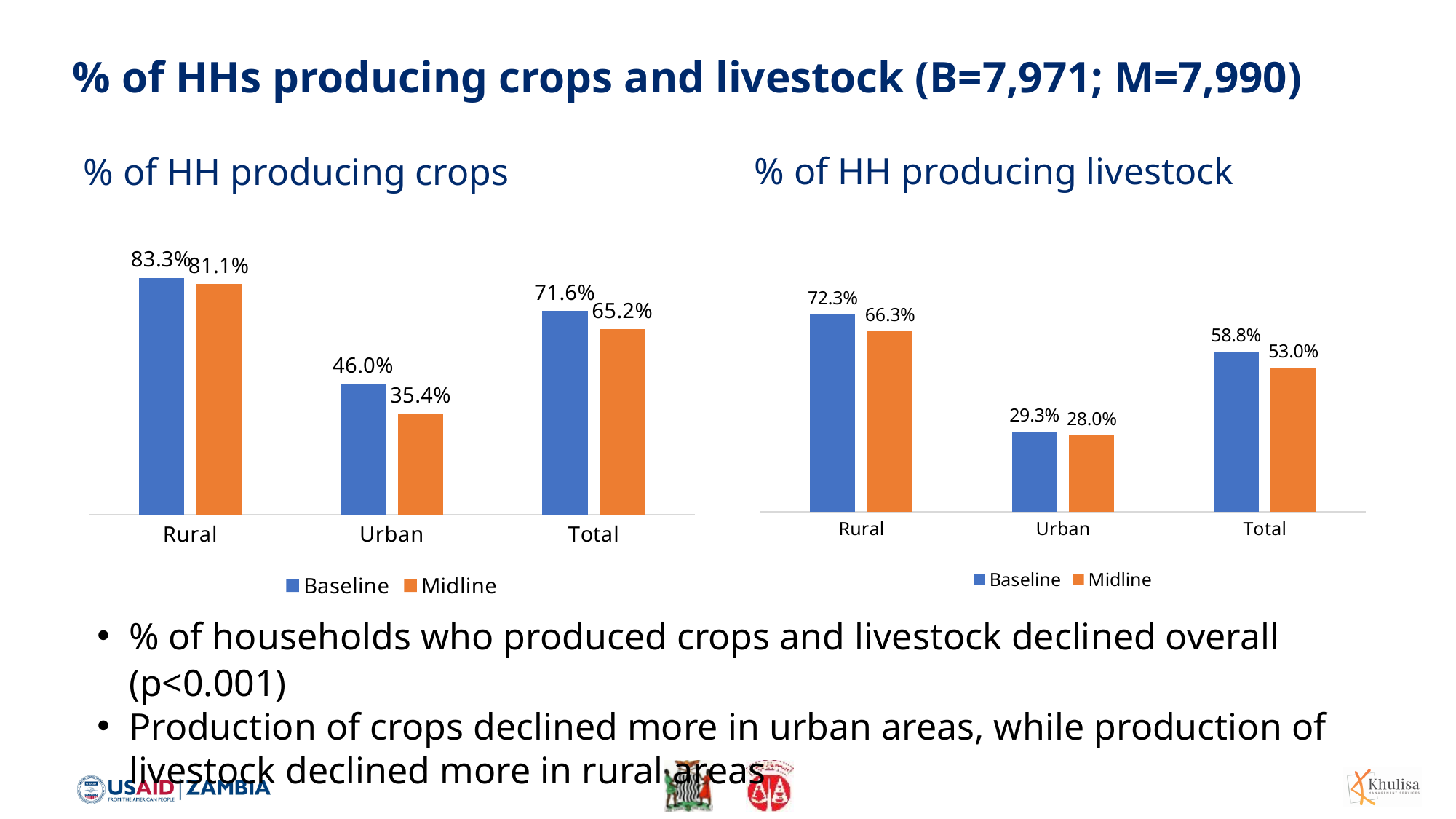
In the '% of HH producing crops' chart, which is larger: the Baseline value for Total or the Midline value for Total? Baseline In the '% of HH producing livestock' chart, what is the Midline value for Total? 53.0% How many series does the legend of the '% of HH producing crops' chart list? 2 In the '% of HH producing livestock' chart, what is the difference between the Baseline and Midline values for Rural? 6.0% In the '% of HH producing livestock' chart, what is the Baseline value for Urban? 29.3% In the '% of HH producing crops' chart, which category has the lowest Midline value? Urban In the '% of HH producing crops' chart, what is the difference between the Baseline and Midline values for Urban? 10.6% In the '% of HH producing crops' chart, what is the Midline value for Urban? 35.4% In the '% of HH producing livestock' chart, which category has the highest Baseline value? Rural What type of chart is the '% of HH producing livestock' chart? Bar chart How many categories are shown on the x axis of the '% of HH producing livestock' chart? 3 In the '% of HH producing crops' chart, what is the Baseline value for Rural? 83.3%